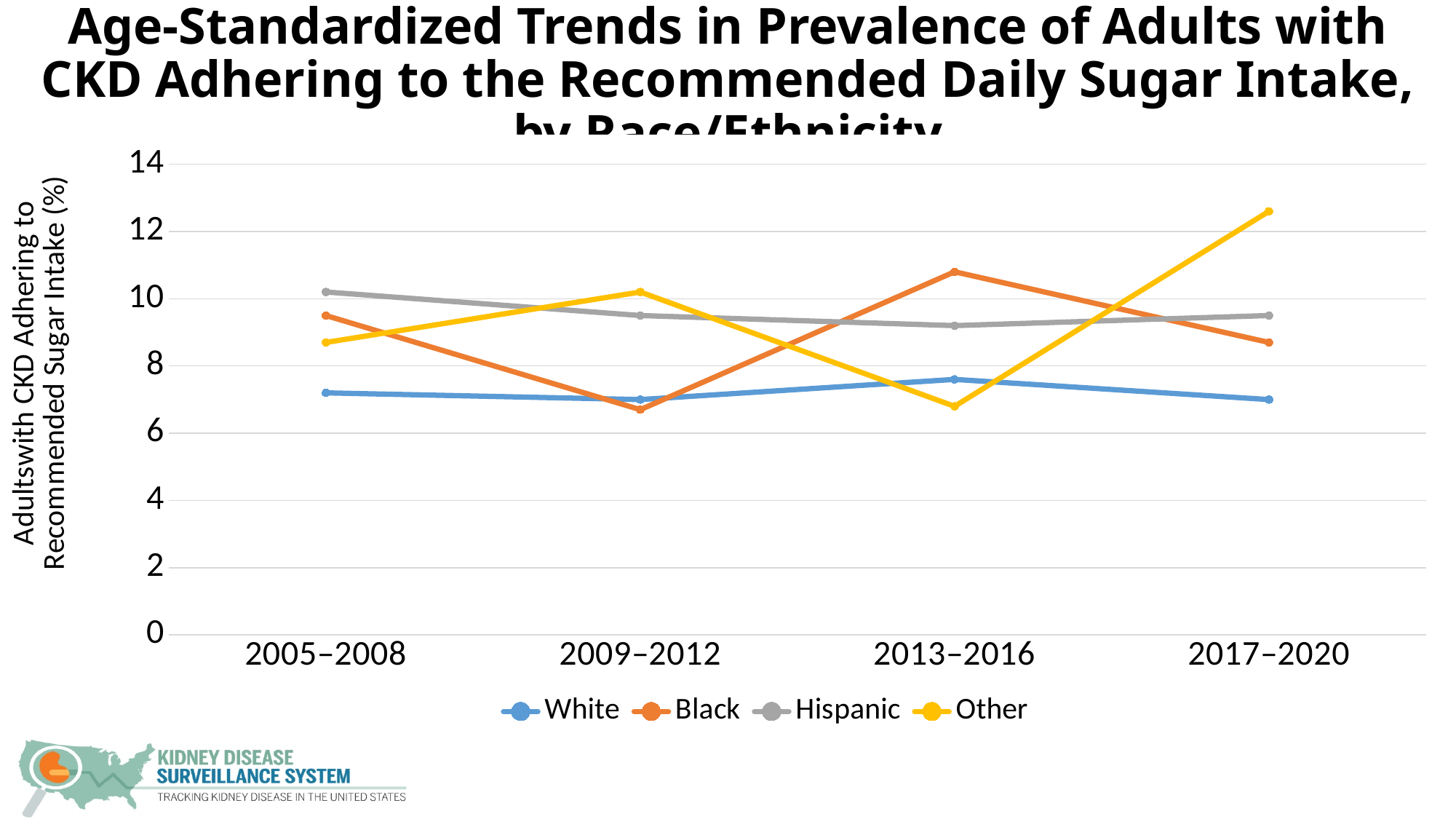
Which race/ethnicity group has the lowest value in 2013–2016? Other Does the value for Other rise or fall from 2013–2016 to 2017–2020? rise Which race/ethnicity group has the highest value in 2017–2020? Other Is the value for Other in 2017–2020 greater or less than 12? greater How many time periods are shown on the x axis? 4 Which race/ethnicity group has the highest value in 2005–2008? Hispanic Is the value for Black in 2013–2016 greater or less than 10? greater What colour is the line for Black in the legend? orange How many series does the legend list? 4 Is the value for White in 2005–2008 greater or less than 8? less In 2013–2016, which is larger, the value for Black or the value for White? Black What kind of chart is shown on the slide? line chart